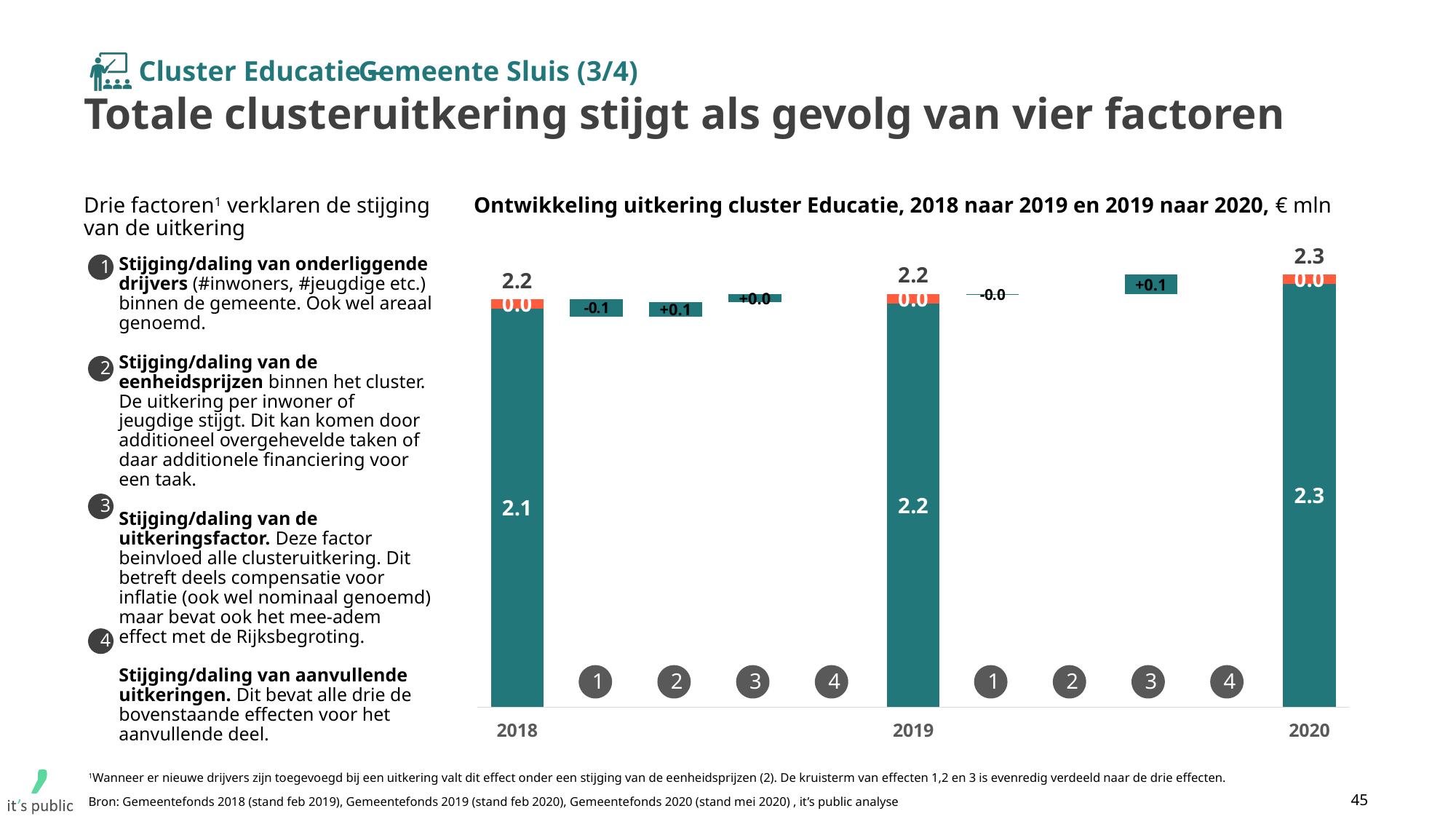
Which year has the highest total uitkering? 2020 What unit is the chart expressed in, according to its title? € mln How many year totals are shown in the chart? 3 What is the value of the large teal segment of the 2018 bar? 2.1 What is the value of factor 3 in the change from 2019 to 2020? +0.1 What is the value of factor 2 in the change from 2018 to 2019? +0.1 What kind of chart is shown on the slide? bar chart (waterfall) What is the total uitkering for cluster Educatie in 2018? 2.2 What is the difference between the total uitkering in 2020 and in 2018? 0.1 What is the total uitkering for cluster Educatie in 2020? 2.3 Is the total uitkering in 2020 larger or smaller than in 2019? larger What is the value of factor 1 in the change from 2018 to 2019? -0.1